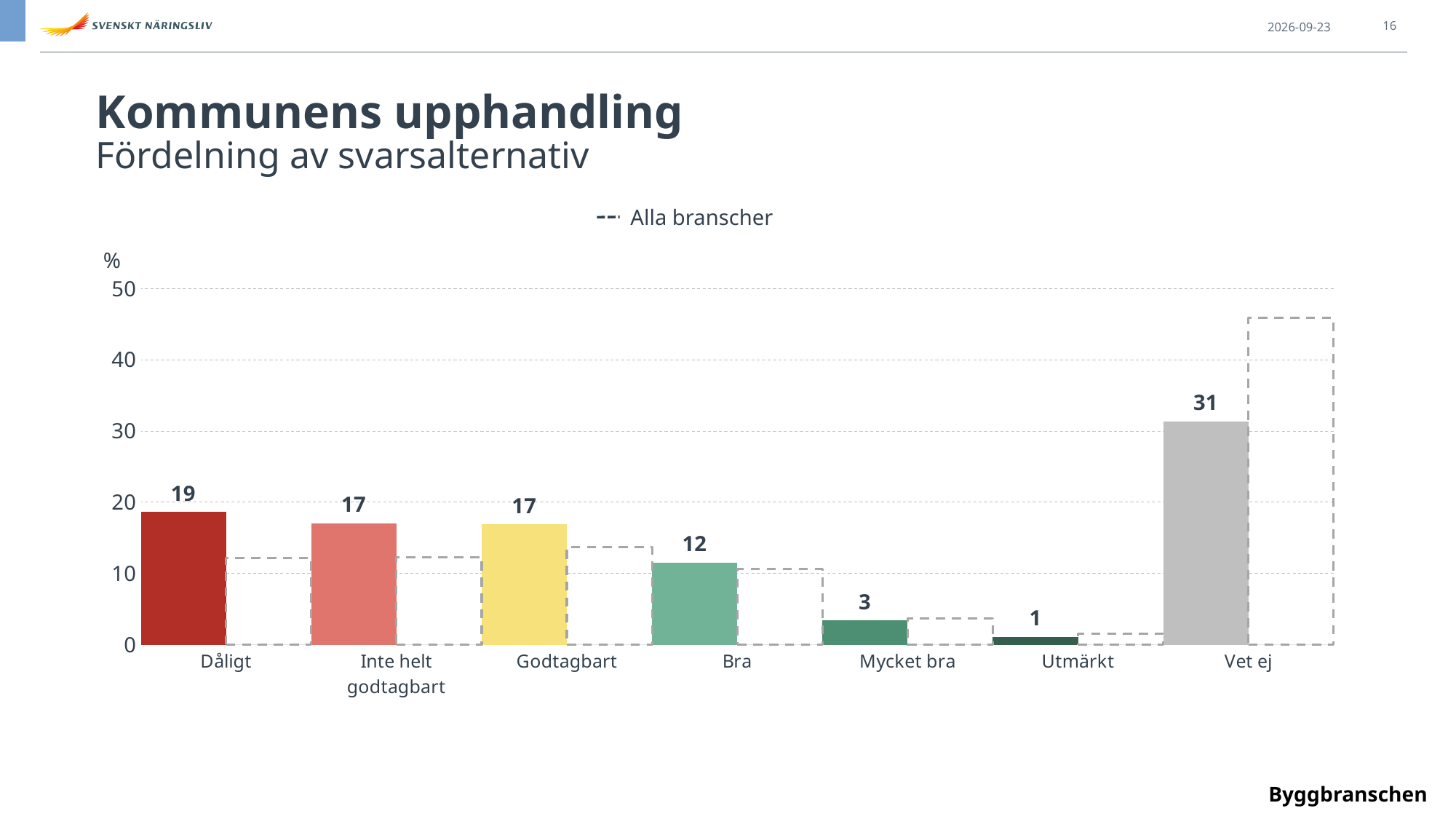
Which category has the lowest value? Utmärkt What is the value for Utmärkt? 1 What is the value for Bra? 12 Which category has the highest value? Vet ej What kind of chart is shown on the slide? bar chart What is the value for Vet ej? 31 Which is larger, the value for Bra or the value for Mycket bra? Bra What is the only entry listed in the chart legend? Alla branscher Is the dashed Alla branscher value for Vet ej greater or less than 40? greater What is the value for Dåligt? 19 What is the difference between the values for Vet ej and Dåligt? 12 How many categories are shown on the x axis? 7